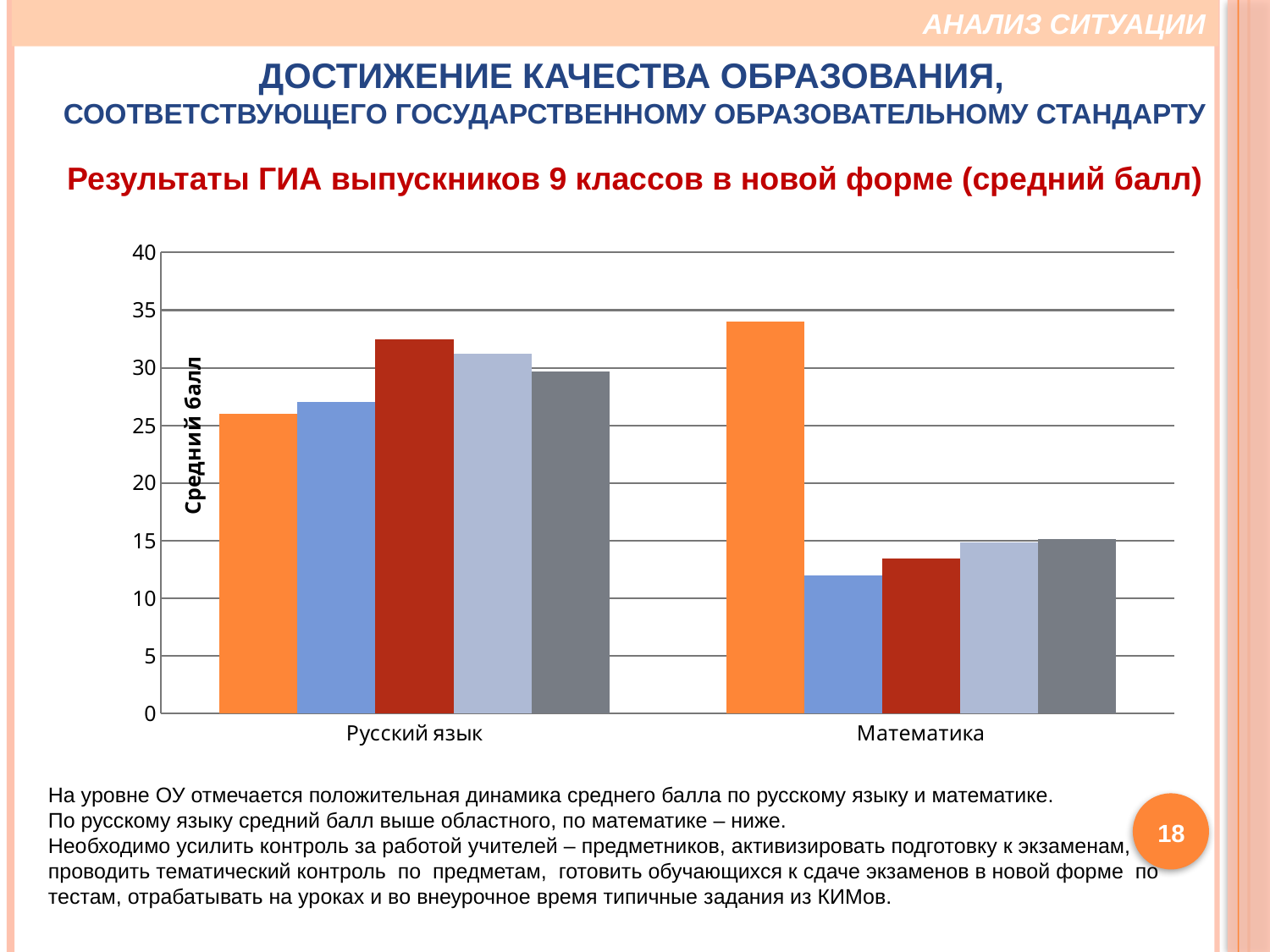
For the blue bars, which category has the larger value, Русский язык or Математика? Русский язык Is the value of the orange bar for Русский язык greater or less than 30? less Is the value of the blue bar for Математика greater or less than 15? less Is the value of the red bar for Математика greater or less than 15? less What is the title of the chart on the slide? Результаты ГИА выпускников 9 классов в новой форме (средний балл) What kind of chart is shown on the slide? bar chart How many bars are plotted for each category in the chart? 5 What is the label of the vertical axis of the chart? Средний балл For the orange bars, which category has the larger value, Русский язык or Математика? Математика How many categories are shown on the x axis of the chart? 2